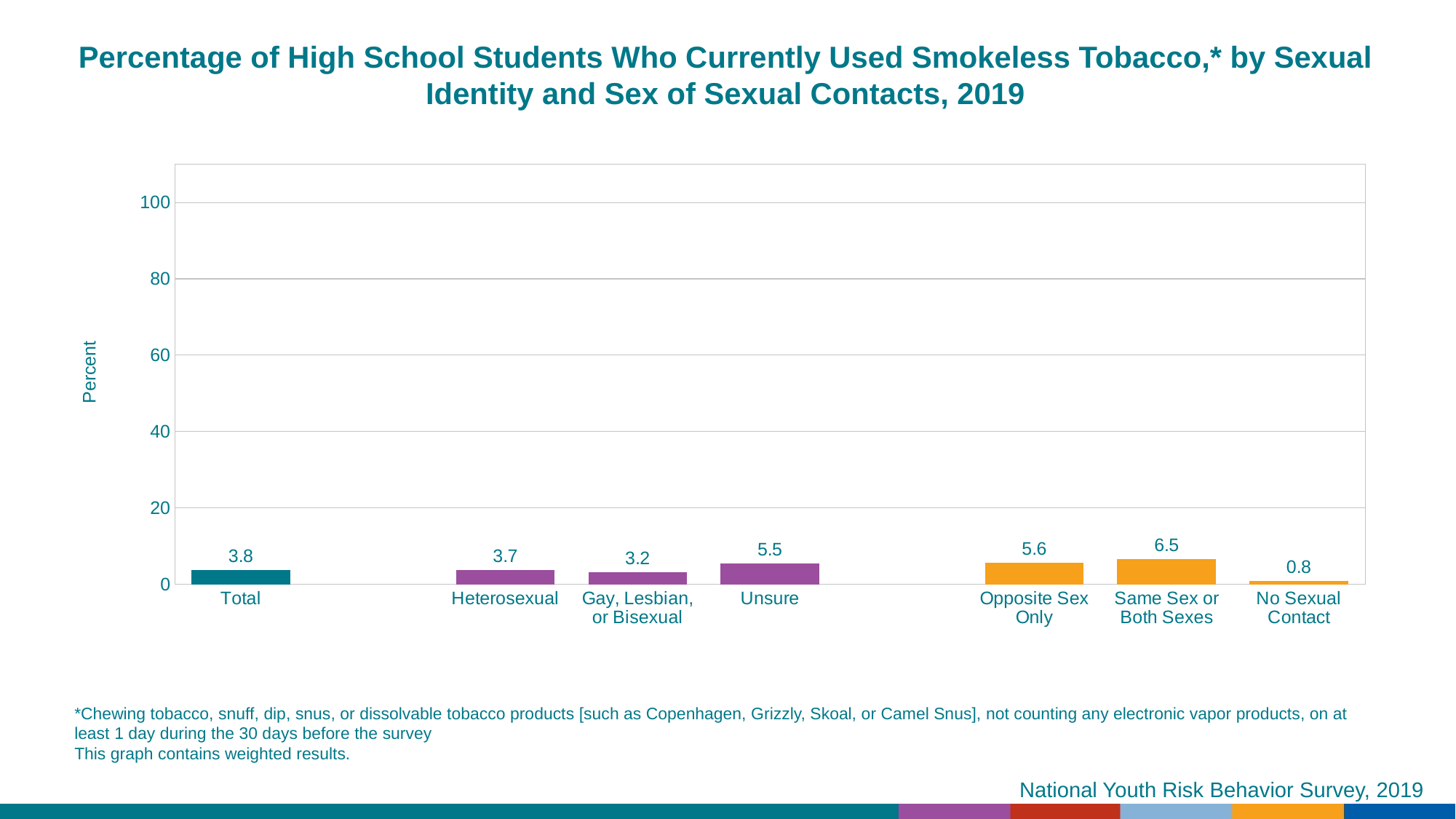
What is the value for Total? 3.8 What is the difference between the values for Unsure and Gay, Lesbian, or Bisexual? 2.3 What is the value for Heterosexual students? 3.7 What is the difference between the values for Same Sex or Both Sexes and Opposite Sex Only? 0.9 Which category has the lowest value? No Sexual Contact Which category has the highest value? Same Sex or Both Sexes What is the value for students with No Sexual Contact? 0.8 Is the value for Same Sex or Both Sexes greater or less than 20? less What is the value for Gay, Lesbian, or Bisexual students? 3.2 How many categories are shown on the chart? 7 Which is larger, the value for Unsure or the value for Heterosexual? Unsure What kind of chart is this? bar chart